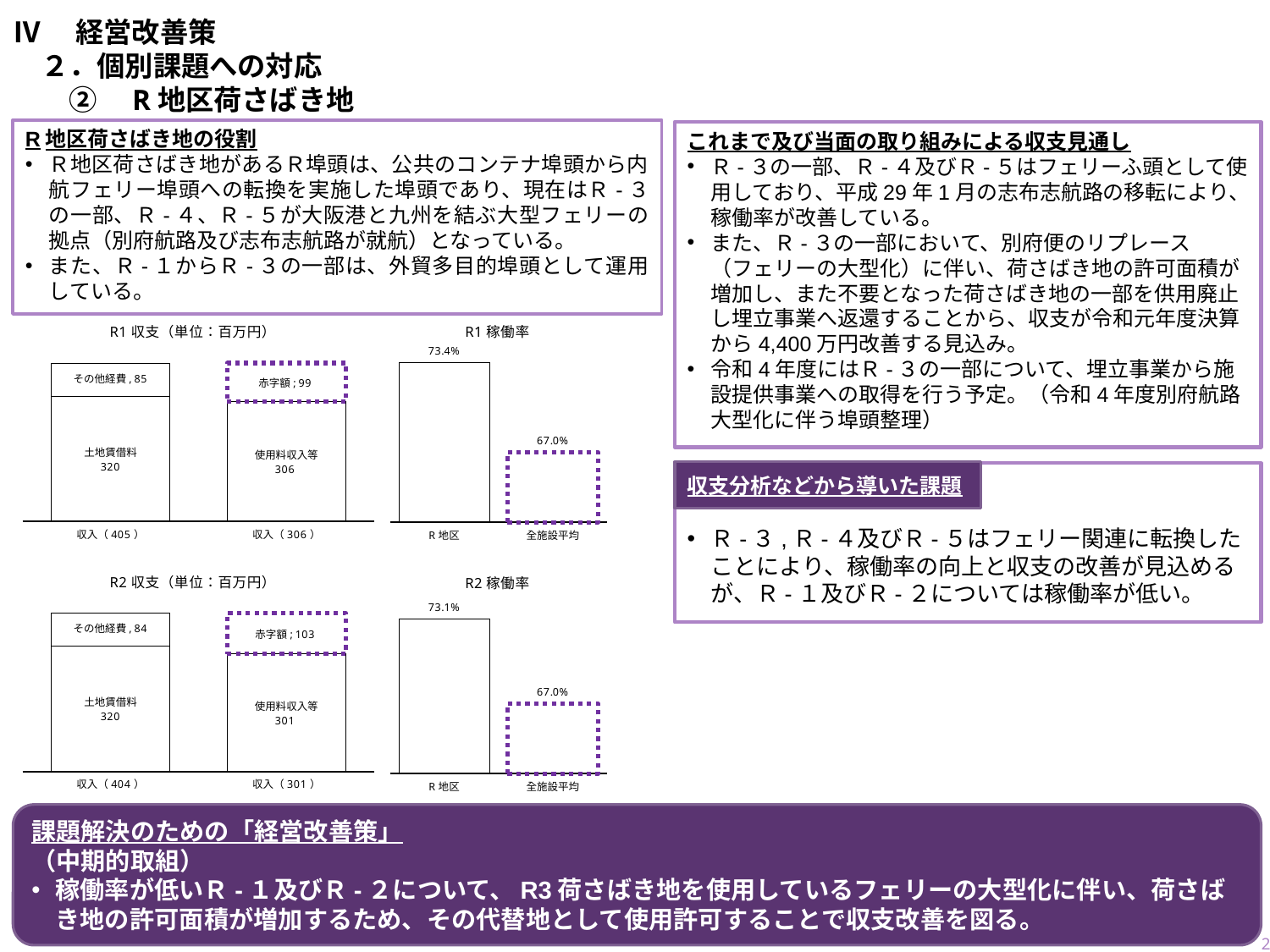
In the R1 稼働率 chart, which category is higher, R 地区 or 全施設平均? R 地区 In the R1 稼働率 chart, what is the value for 全施設平均? 67.0% In the R2 収支 chart, what is the value of 赤字額? 103 In the R1 稼働率 chart, what is the difference between R 地区 and 全施設平均? 6.4% In the R2 稼働率 chart, what is the difference between R 地区 and 全施設平均? 6.1% In the R1 収支 chart, what is the value of 赤字額? 99 In the R1 収支 chart, what is the value of 土地賃借料? 320 In the R1 稼働率 chart, what is the value for R 地区? 73.4% In the R1 収支 chart, what is the total of the left stacked bar (土地賃借料 plus その他経費)? 405 In the R2 稼働率 chart, what is the value for R 地区? 73.1% What kind of chart is the R2 稼働率 chart? Bar chart In the R2 収支 chart, what is the value of 使用料収入等? 301